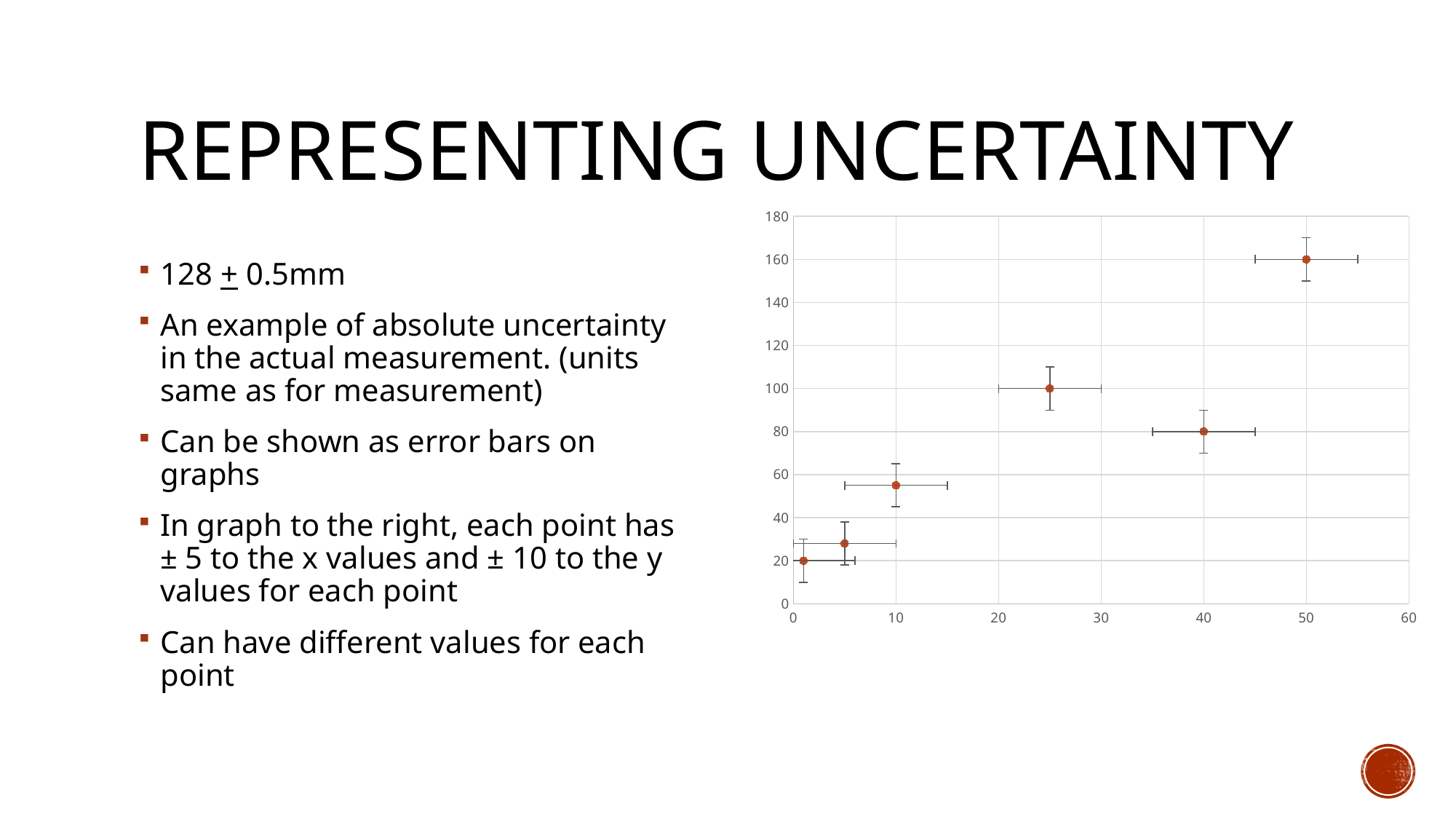
What is the y value of the lowest point on the chart? 20 What is the y value of the point plotted at x = 40? 80 Is the y value of the point at x = 10 greater or less than 40? greater What feature is drawn on each data point to show uncertainty? Error bars Do the y values generally rise or fall as x increases along the x axis? Rise At which x value is the point with the highest y value? 50 Is the y value of the point at x = 25 greater or less than 120? less What kind of chart is shown on the slide? Scatter chart What is the y value of the point plotted at x = 50? 160 Which point has the larger y value, the one at x = 25 or the one at x = 40? The point at x = 25 How many data points are plotted on the chart? 6 What is the difference between the y values of the points at x = 50 and x = 40? 80